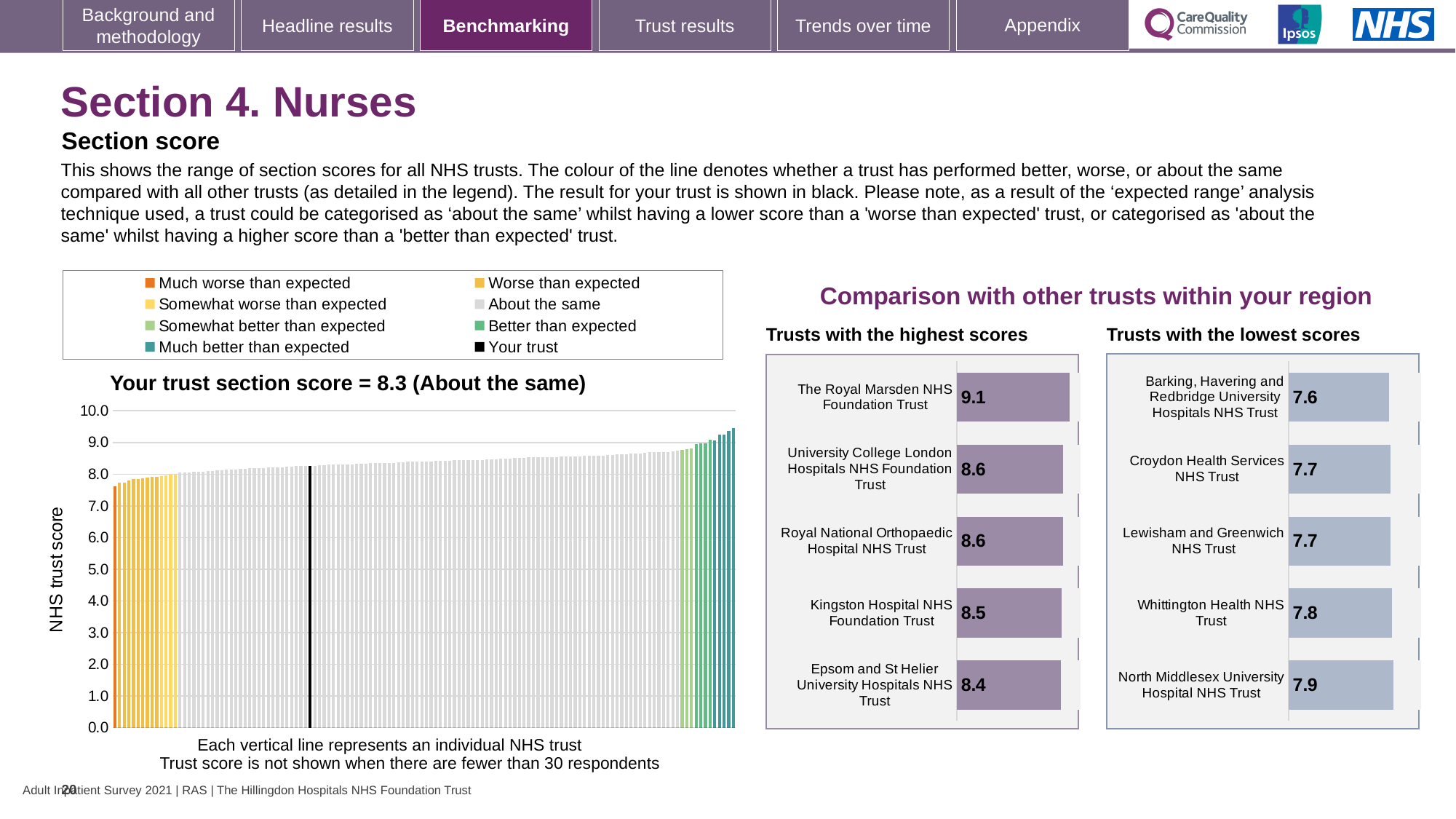
In the 'Trusts with the highest scores' chart, which trust has the highest score? The Royal Marsden NHS Foundation Trust In the 'Trusts with the highest scores' chart, what is the score for Kingston Hospital NHS Foundation Trust? 8.5 In the 'Trusts with the lowest scores' chart, what is the score for Barking, Havering and Redbridge University Hospitals NHS Trust? 7.6 In the 'Trusts with the lowest scores' chart, which trust has the lowest score? Barking, Havering and Redbridge University Hospitals NHS Trust How many trusts are shown in the 'Trusts with the lowest scores' chart? 5 How many entries does the legend of the main chart of all NHS trusts list? 8 In the 'Trusts with the lowest scores' chart, what is the score for North Middlesex University Hospital NHS Trust? 7.9 In the 'Trusts with the highest scores' chart, what is the difference between the scores of The Royal Marsden NHS Foundation Trust and Epsom and St Helier University Hospitals NHS Trust? 0.7 In the main chart of all NHS trusts, what is the section score for your trust? 8.3 In the 'Trusts with the lowest scores' chart, which has the larger score: Whittington Health NHS Trust or Croydon Health Services NHS Trust? Whittington Health NHS Trust In the 'Trusts with the highest scores' chart, what is the score for The Royal Marsden NHS Foundation Trust? 9.1 In the main chart of all NHS trusts, do the trust scores rise or fall from left to right? rise